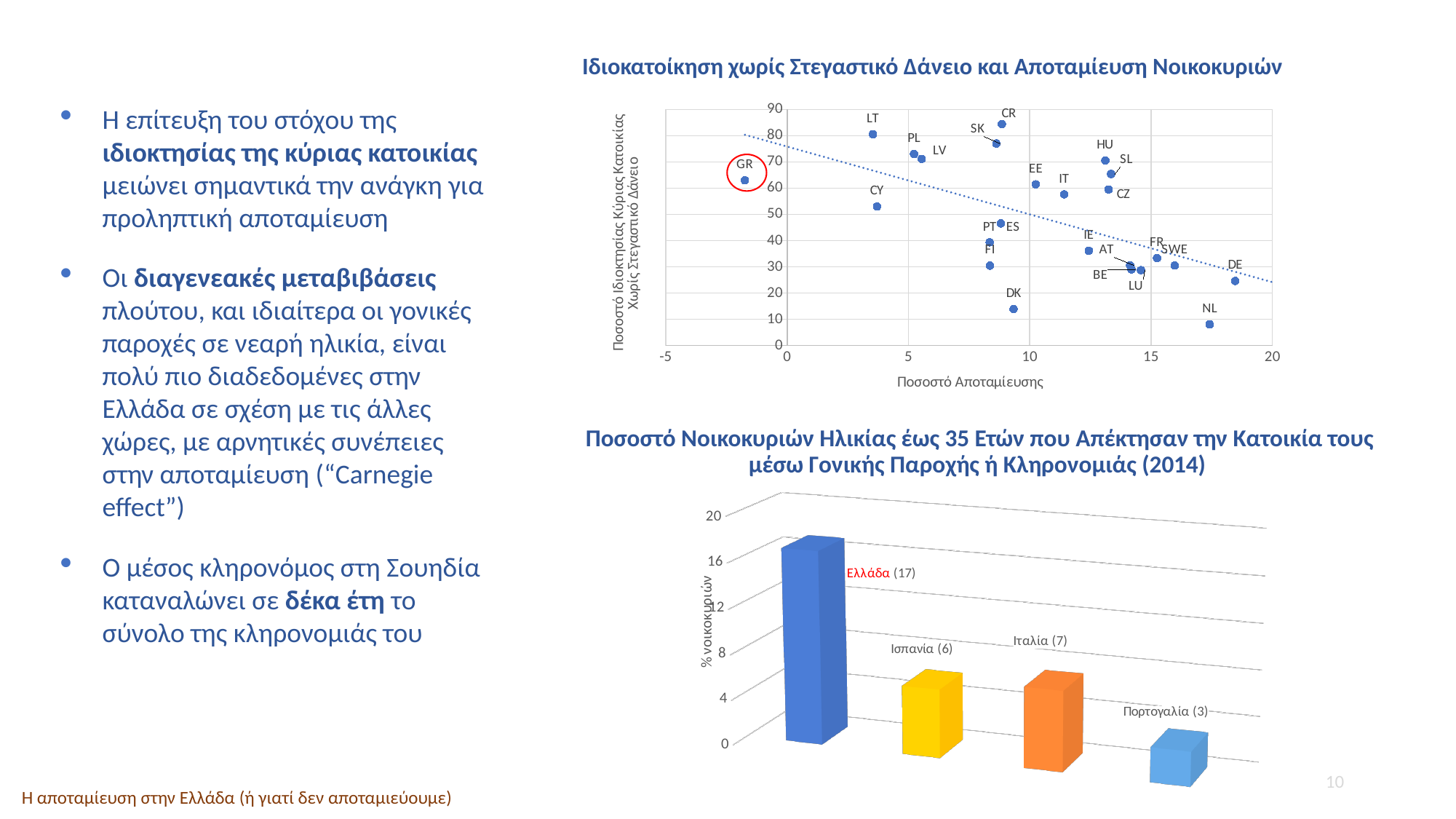
What kind of chart is the bottom chart? Bar chart In the bottom chart, what is the value for Πορτογαλία? 3 What kind of chart is the top chart (Ιδιοκατοίκηση χωρίς Στεγαστικό Δάνειο και Αποταμίευση Νοικοκυριών)? Scatter chart In the bottom chart, which is larger, the value for Ισπανία or Ιταλία? Ιταλία In the bottom chart, what is the difference between the values for Ελλάδα and Ιταλία? 10 How many countries are shown in the bottom chart? 4 In the bottom chart (Ποσοστό Νοικοκυριών Ηλικίας έως 35 Ετών...), what is the value for Ελλάδα? 17 In the bottom chart, which country has the lowest value? Πορτογαλία In the top chart, does the dotted trend line rise or fall as Ποσοστό Αποταμίευσης increases? Falls In the bottom chart, which country has the highest value? Ελλάδα In the top chart, is the Ποσοστό Αποταμίευσης value for GR greater or less than 0? less In the top chart, which country has the lowest value on the vertical axis? NL